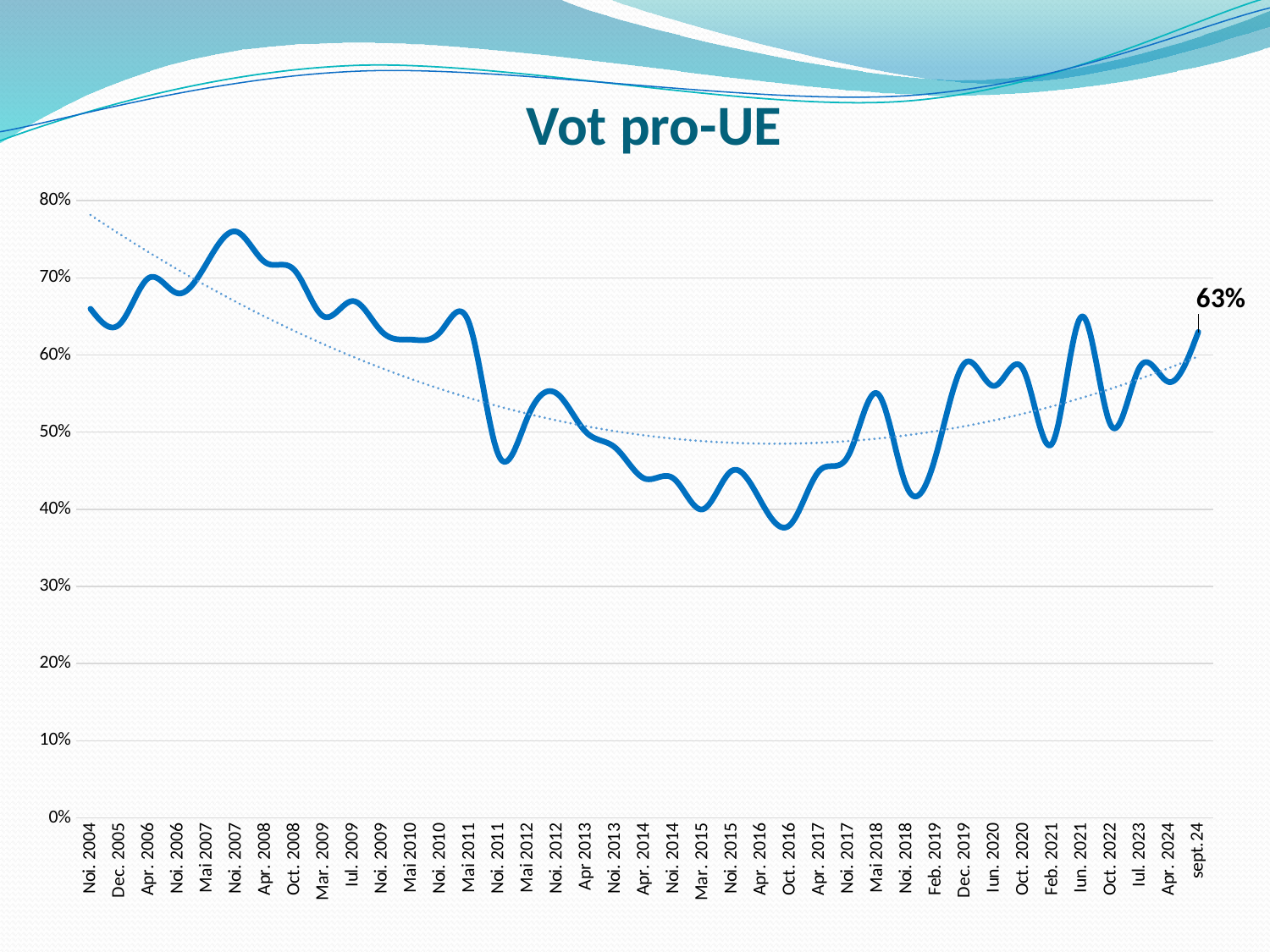
What is the title of the chart? Vot pro-UE Which x-axis point has the highest value? Noi. 2007 What is the value shown for sept. 24? 63% Which is larger, the value for Noi. 2004 or the value for Noi. 2011? Noi. 2004 Which x-axis point has the lowest value? Oct. 2016 Is the value for Iun. 2021 greater or less than 60%? greater Does the line rise or fall from Oct. 2016 to sept. 24? rise What kind of chart is shown on the slide? line chart How many points are labelled on the x axis? 39 Is the value for Noi. 2011 greater or less than 50%? less Is the value for Noi. 2007 greater or less than 70%? greater